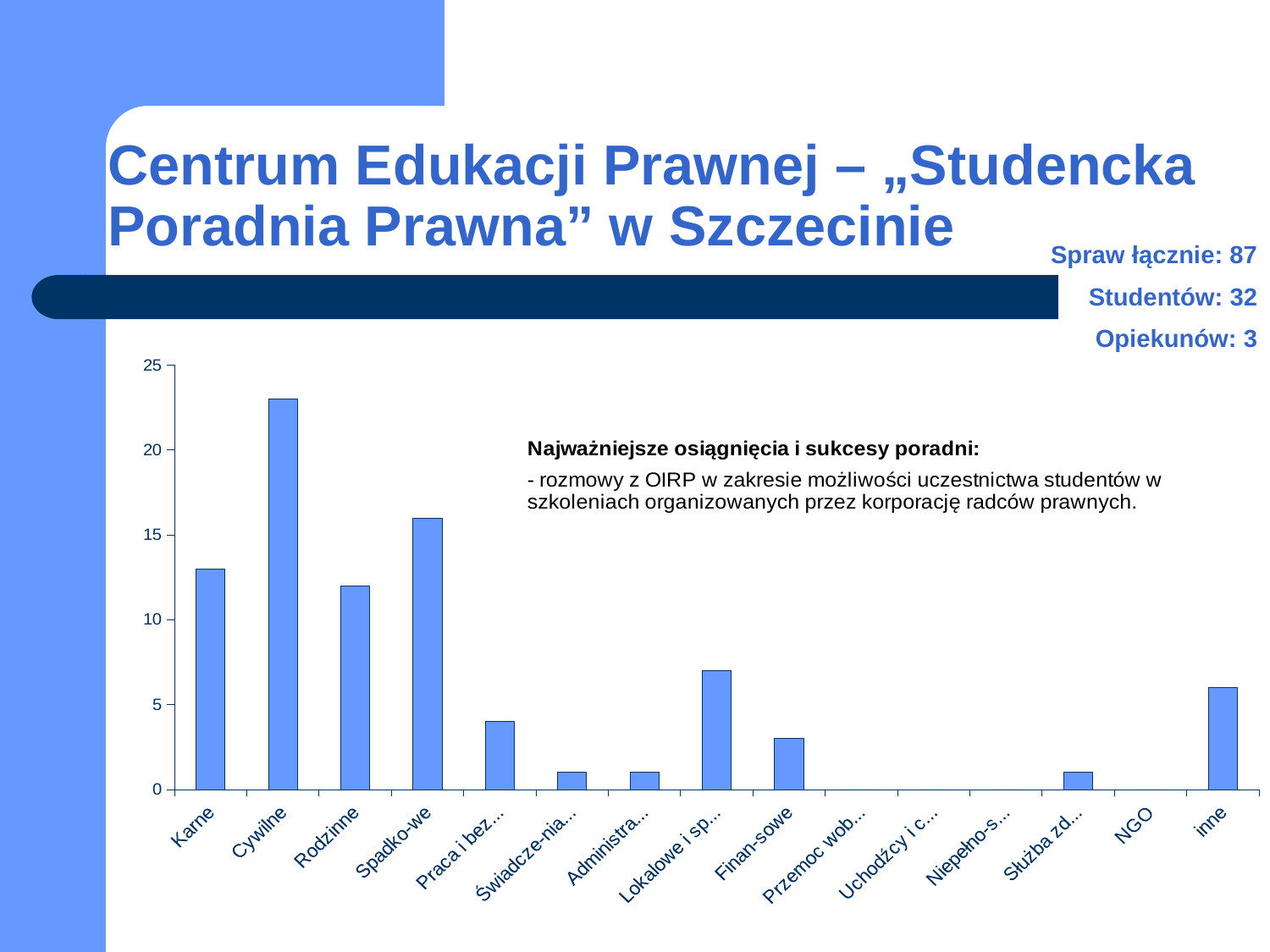
What kind of chart is shown on the slide? bar chart Is the value for Cywilne greater or less than 20? greater Is the value for Karne greater or less than 10? greater Is the value for Praca i bez... greater or less than 5? less Which category has the highest bar in the chart? Cywilne Which is larger, the value for Spadko-we or the value for Karne? Spadko-we How many categories are shown on the x axis of the chart? 15 What is the highest value shown on the y axis of the chart? 25